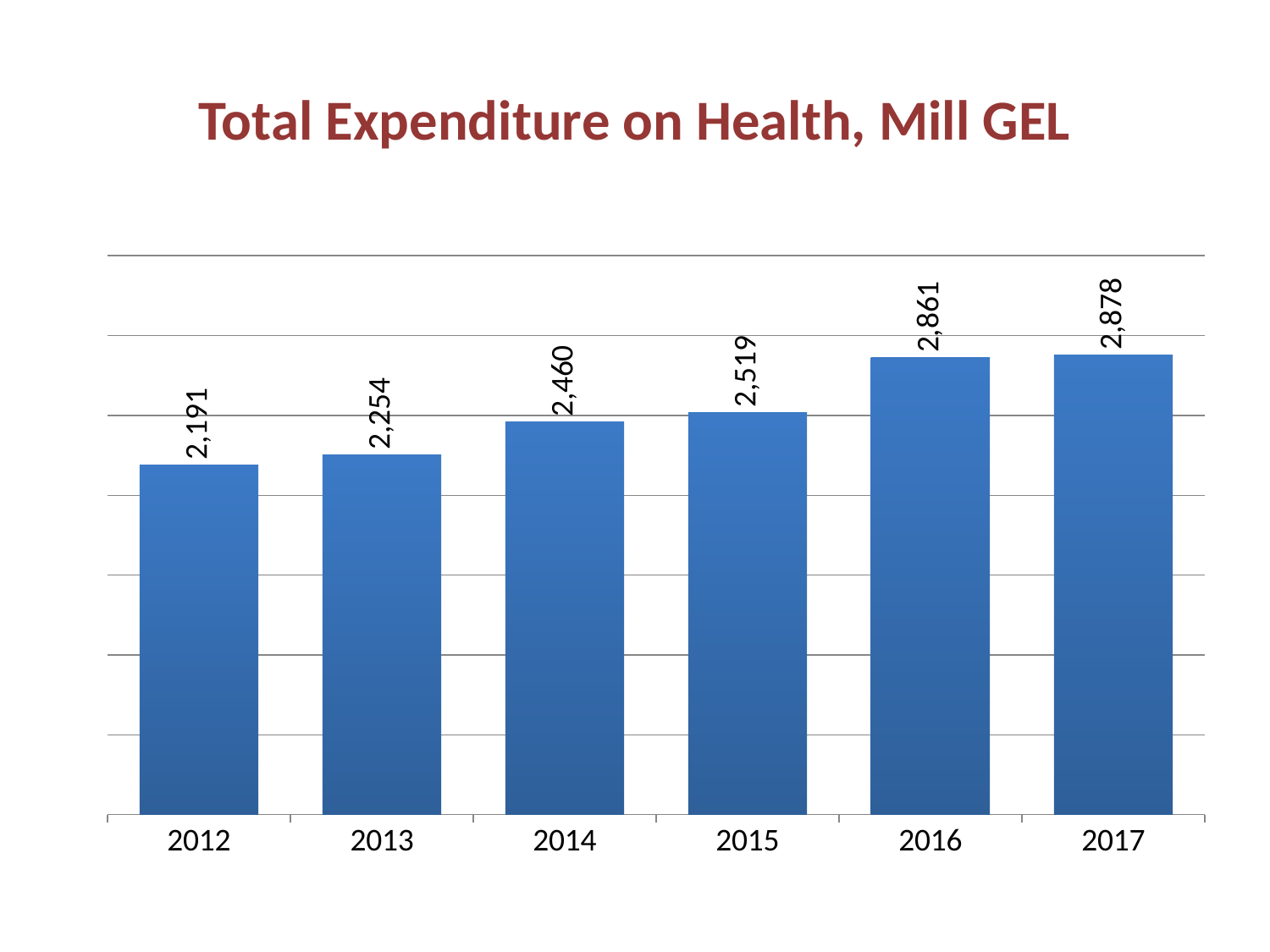
Which year has the highest total expenditure on health? 2017 What is the total expenditure on health for 2015? 2,519 What is the total expenditure on health for 2012? 2,191 How many years are shown on the chart? 6 What is the difference in total expenditure on health between 2016 and 2015? 342 Which year has the lowest total expenditure on health? 2012 What is the difference in total expenditure on health between 2014 and 2013? 206 Which year has a larger total expenditure on health, 2013 or 2014? 2014 What kind of chart is shown on the slide? Bar chart What is the total expenditure on health for 2017? 2,878 Do the values rise or fall from 2012 to 2017? Rise What is the title of the chart? Total Expenditure on Health, Mill GEL